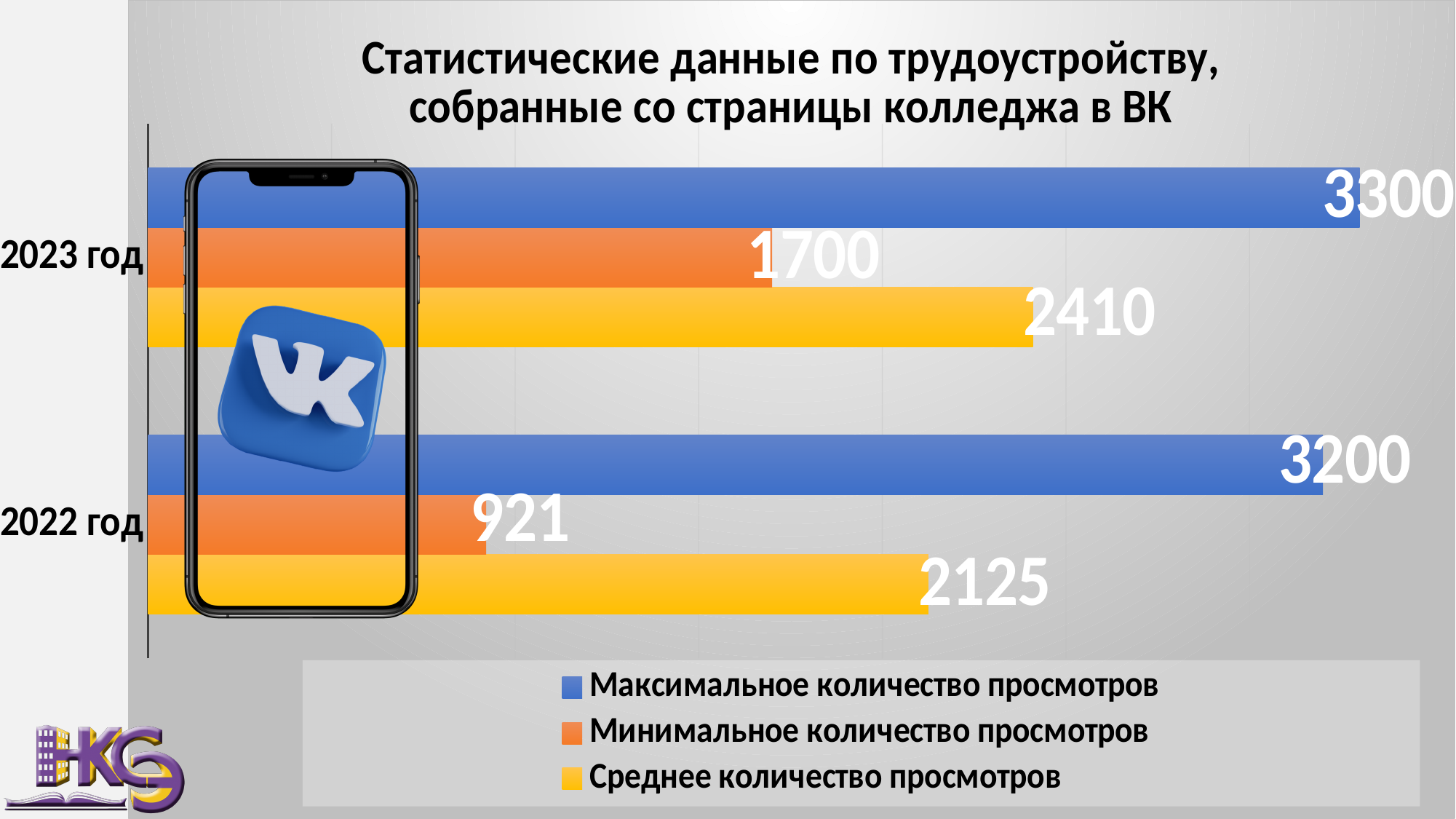
What is the difference between the minimum number of views in 2023 год and 2022 год? 779 What is the difference between the maximum number of views in 2023 год and 2022 год? 100 What is the average number of views (Среднее количество просмотров) for 2023 год? 2410 What is the minimum number of views (Минимальное количество просмотров) for 2022 год? 921 Which year has the higher minimum number of views? 2023 год Which colour represents Среднее количество просмотров in the legend? Yellow How many years (categories) are shown on the chart? 2 What is the average number of views (Среднее количество просмотров) for 2022 год? 2125 What kind of chart is shown on the slide? Bar chart How many series does the legend list? 3 Which year has the lowest average number of views? 2022 год What is the maximum number of views (Максимальное количество просмотров) for 2023 год? 3300